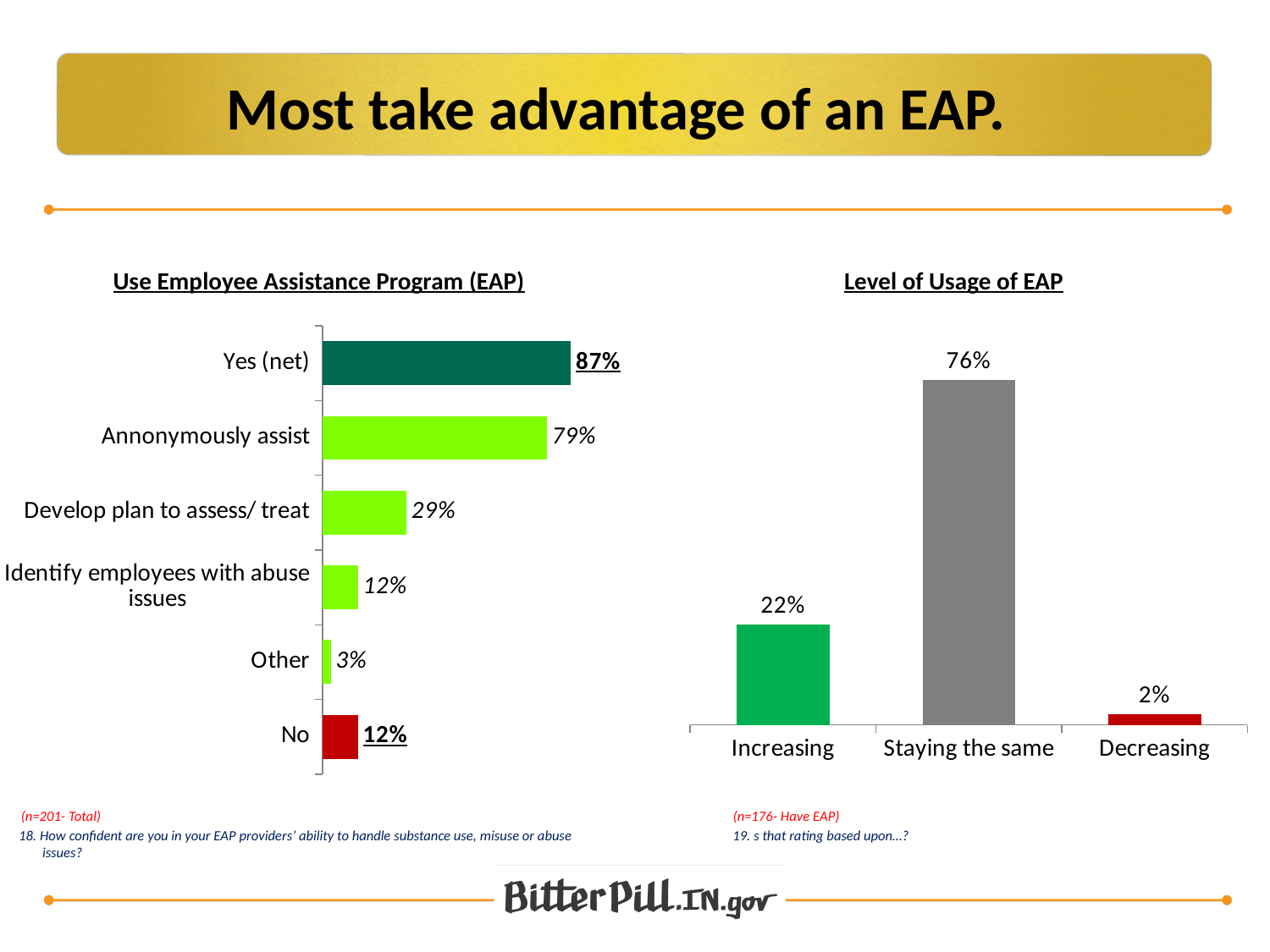
In the 'Use Employee Assistance Program (EAP)' chart, what is the difference between 'Annonymously assist' and 'Develop plan to assess/ treat'? 50% In the 'Level of Usage of EAP' chart, what is the difference between 'Increasing' and 'Decreasing'? 20% In the 'Use Employee Assistance Program (EAP)' chart, what is the value for 'Yes (net)'? 87% In the 'Use Employee Assistance Program (EAP)' chart, which category has the lowest value? Other In the 'Use Employee Assistance Program (EAP)' chart, what is the value for 'Develop plan to assess/ treat'? 29% In the 'Level of Usage of EAP' chart, what is the value for 'Staying the same'? 76% In the 'Use Employee Assistance Program (EAP)' chart, what kind of chart is it? Bar chart In the 'Use Employee Assistance Program (EAP)' chart, what is the value for 'Other'? 3% In the 'Use Employee Assistance Program (EAP)' chart, how many categories are shown? 6 In the 'Level of Usage of EAP' chart, which is larger, 'Increasing' or 'Decreasing'? Increasing In the 'Level of Usage of EAP' chart, which category has the highest value? Staying the same In the 'Level of Usage of EAP' chart, what is the value for 'Decreasing'? 2%